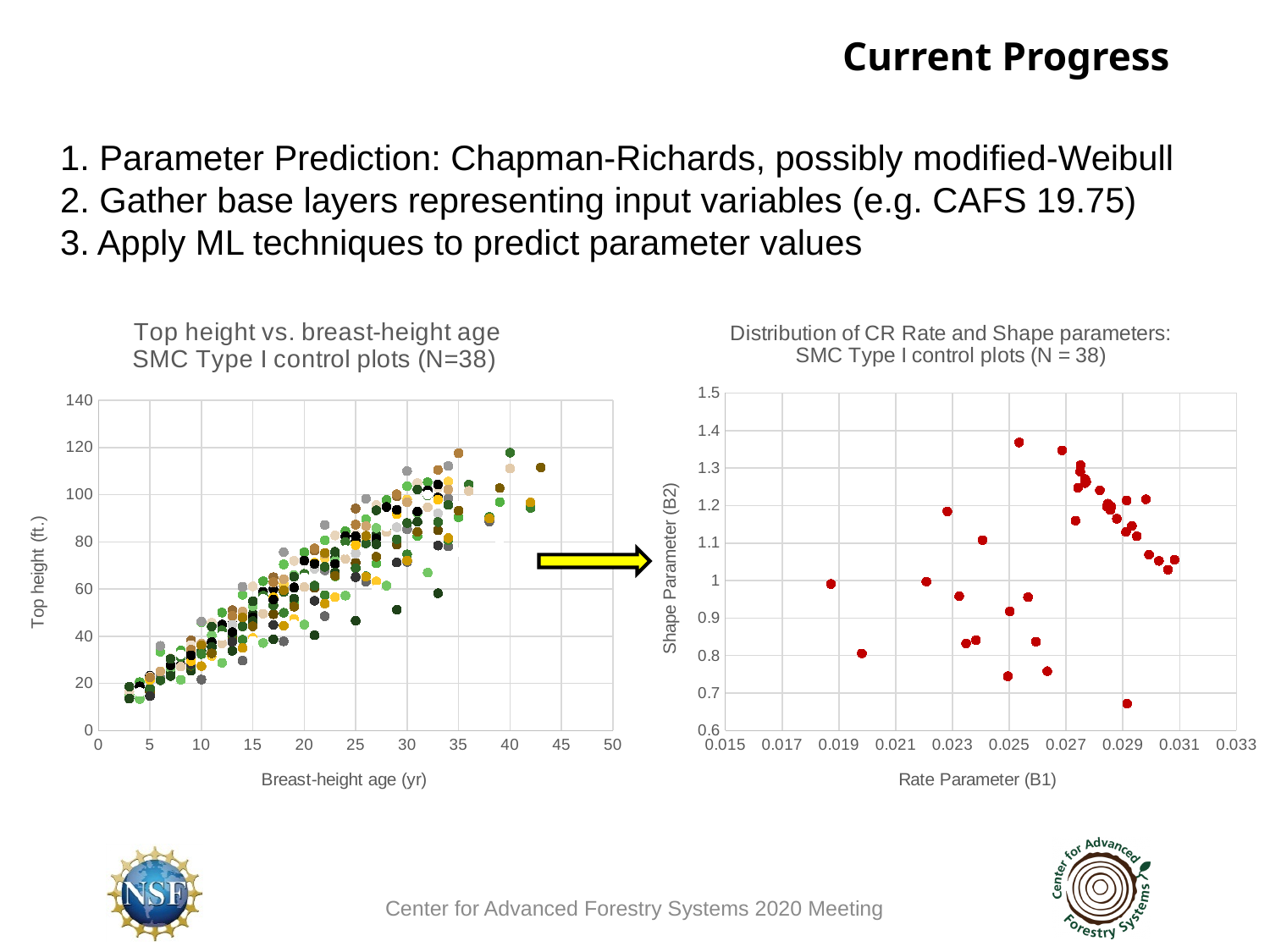
What kind of chart is the 'Distribution of CR Rate and Shape parameters' chart on the right? scatter chart In the left chart, is the lowest top height plotted greater or less than 20 ft? less In the left chart, what is the label of the x axis? Breast-height age (yr) In the left chart, does top height generally rise or fall as breast-height age increases? rise What kind of chart is the 'Top height vs. breast-height age' chart on the left? scatter chart In the right chart, what is the label of the y axis? Shape Parameter (B2) In the left chart, is the highest top height plotted greater or less than 100 ft? greater In the right chart, is the highest shape parameter value greater or less than 1.4? less In the right chart, what is the maximum value shown on the x axis? 0.033 According to the title of the right chart, how many SMC Type I control plots are represented? 38